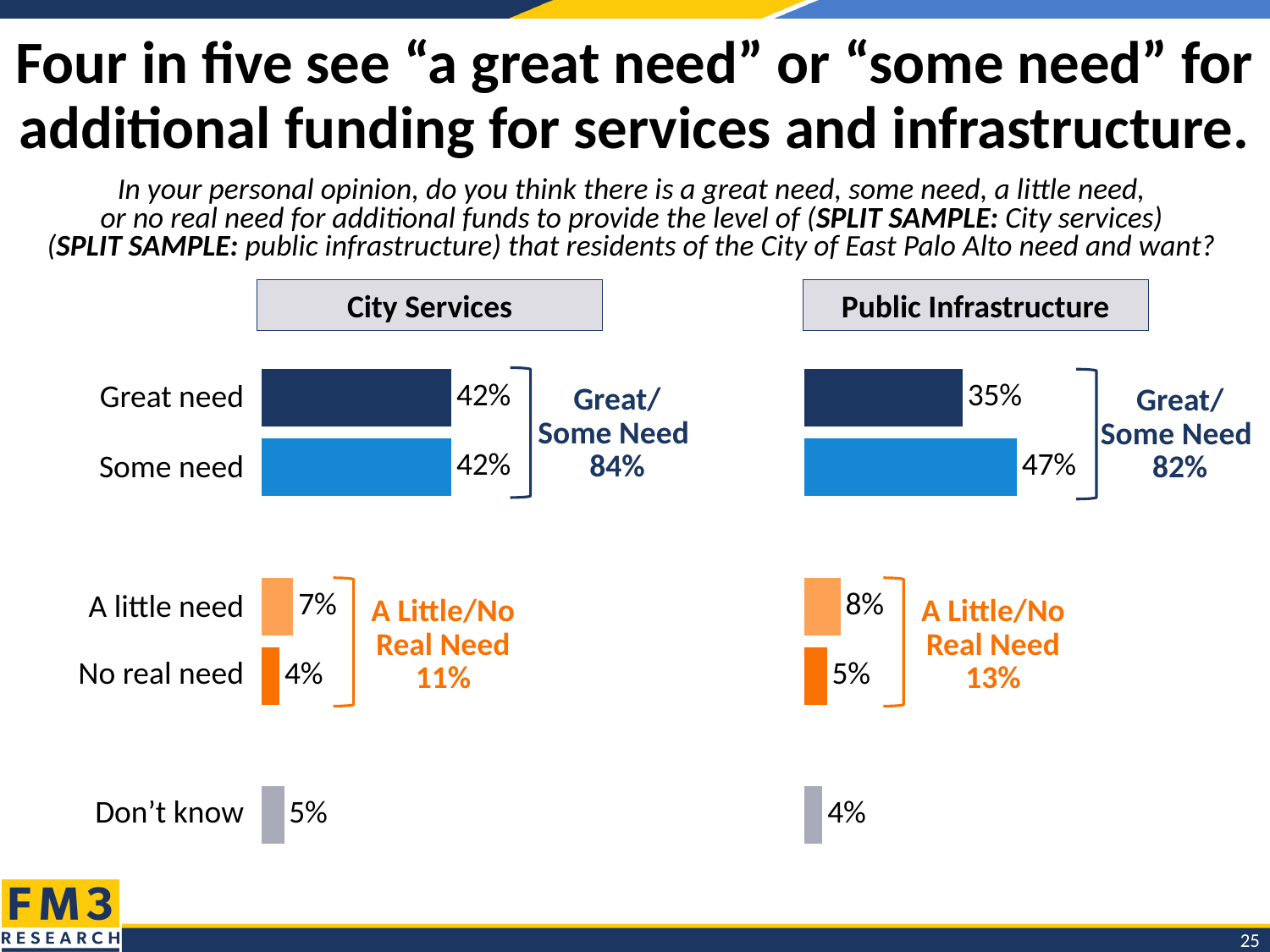
In the Public Infrastructure chart, what is the difference between the some need and great need percentages? 12% Which is larger: the great need percentage for City Services or for Public Infrastructure? City Services How many response categories are shown in the City Services chart? 5 In the City Services chart, what is the combined Great/Some Need percentage shown? 84% In the Public Infrastructure chart, what percentage said there is some need? 47% In the City Services chart, what percentage answered don't know? 5% In the City Services chart, which response category has the lowest percentage? No real need In the Public Infrastructure chart, what is the combined A Little/No Real Need percentage shown? 13% In the Public Infrastructure chart, what percentage said there is a great need? 35% In the City Services chart, what percentage said there is a great need? 42% In the Public Infrastructure chart, which response category has the highest percentage? Some need What type of chart is used on this slide? Bar chart